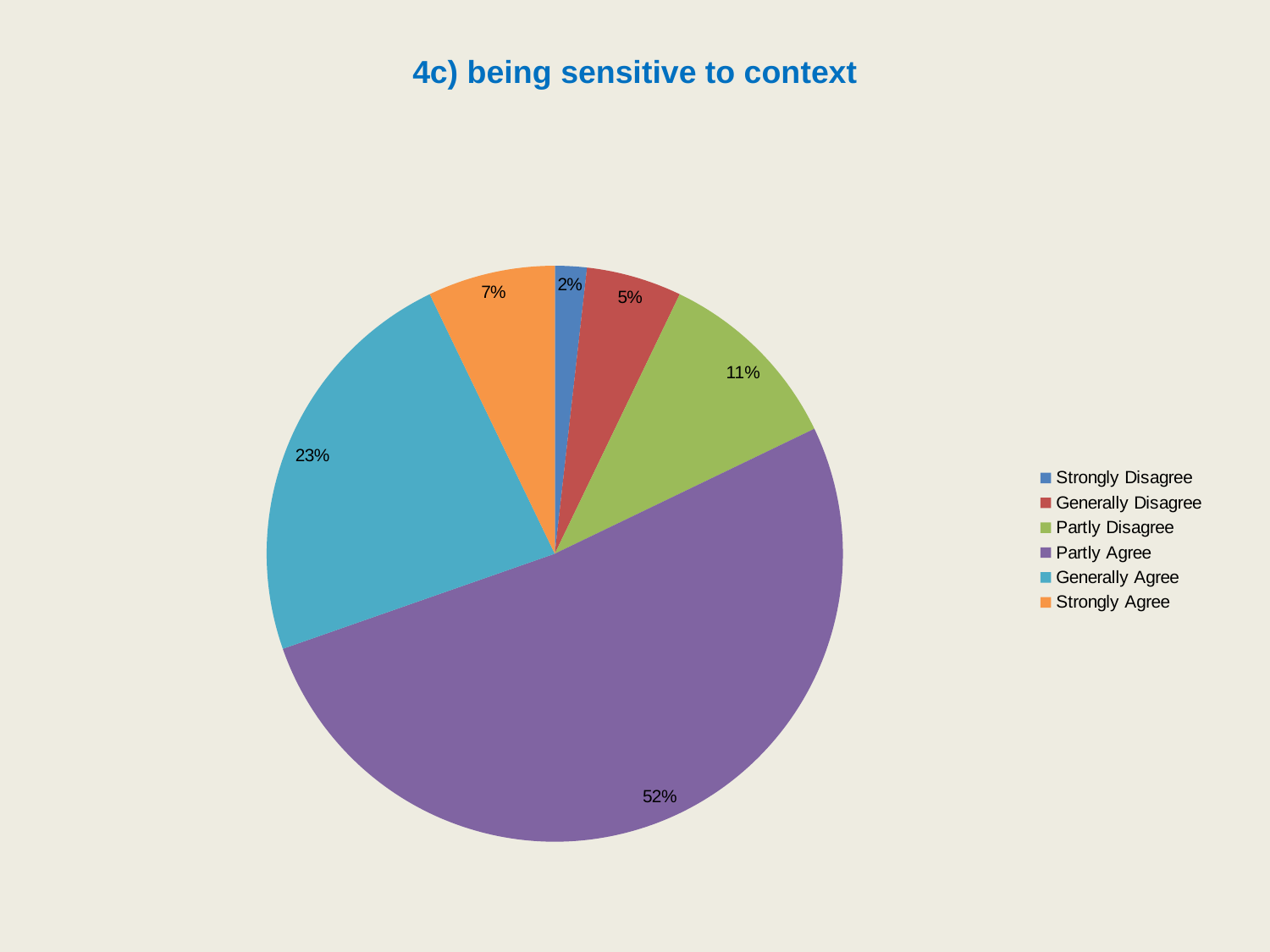
What colour is the Generally Agree slice? teal What is the difference in percentage points between Partly Agree and Generally Agree? 29 What percentage of the pie is Partly Agree? 52% How many categories does the legend list? 6 Which category has the smallest share of the pie? Strongly Disagree What percentage of the pie is Partly Disagree? 11% Which category has the largest share of the pie? Partly Agree What is the title of the chart? 4c) being sensitive to context What kind of chart is shown on the slide? pie chart What percentage of the pie is Strongly Disagree? 2% Which is larger, Strongly Agree or Generally Disagree? Strongly Agree What percentage of the pie is Generally Agree? 23%